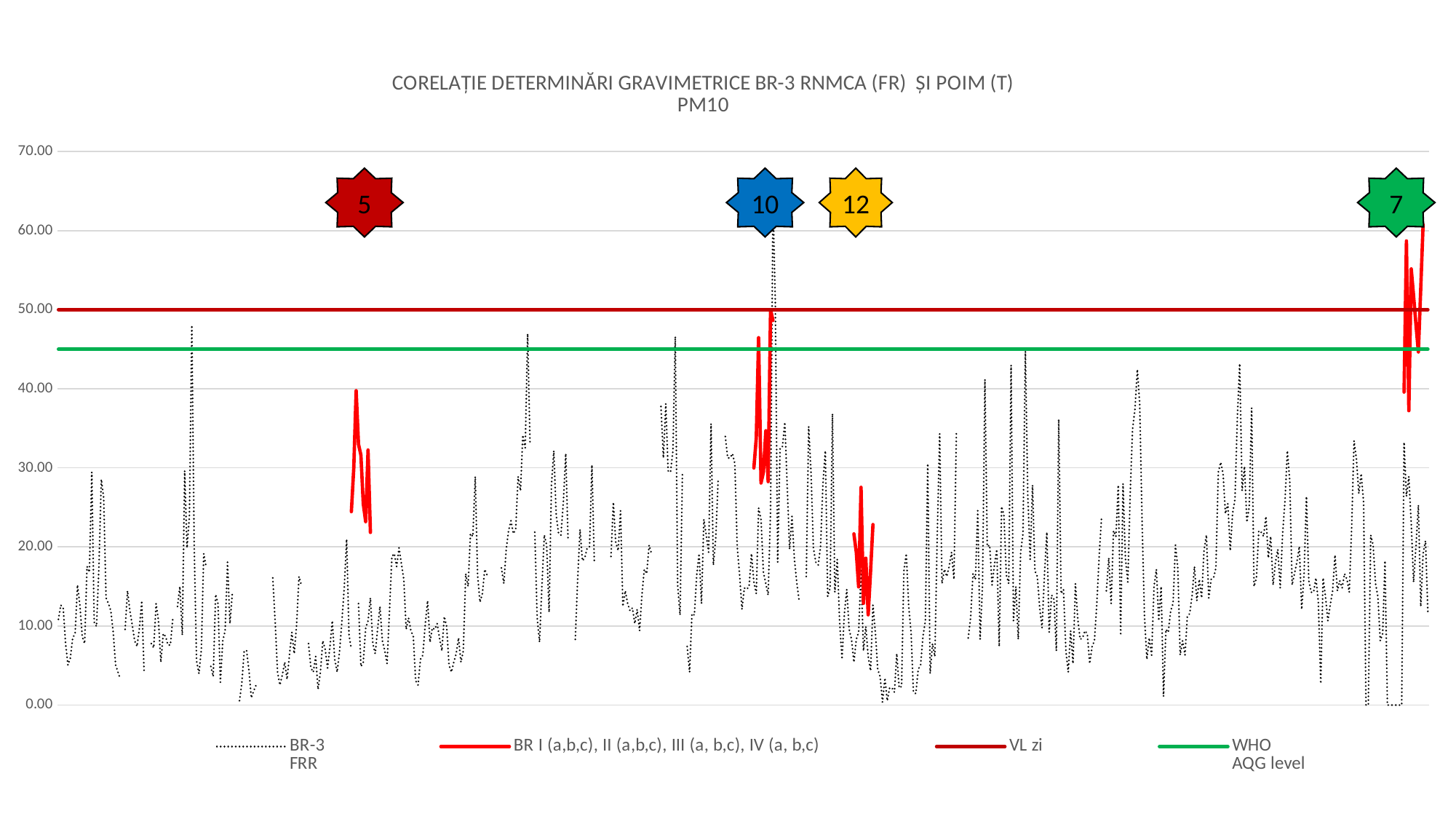
What is the title of the chart? CORELAȚIE DETERMINĂRI GRAVIMETRICE BR-3 RNMCA (FR) ȘI POIM (T) PM10 What is the highest value shown on the y axis? 70.00 Which legend entry is drawn as a green line? WHO AQG level What kind of chart is shown on the slide? line chart Is the highest peak of the red BR I–IV series at the far right of the chart greater or less than 50? greater Is the peak of the red BR I–IV segment below the red star labelled 5 greater or less than 45? less Is the WHO AQG level line greater or less than 50? less At what value does the VL zi horizontal line sit on the y axis? 50.00 Which horizontal reference line is higher, VL zi or WHO AQG level? VL zi How many series does the legend list? 4